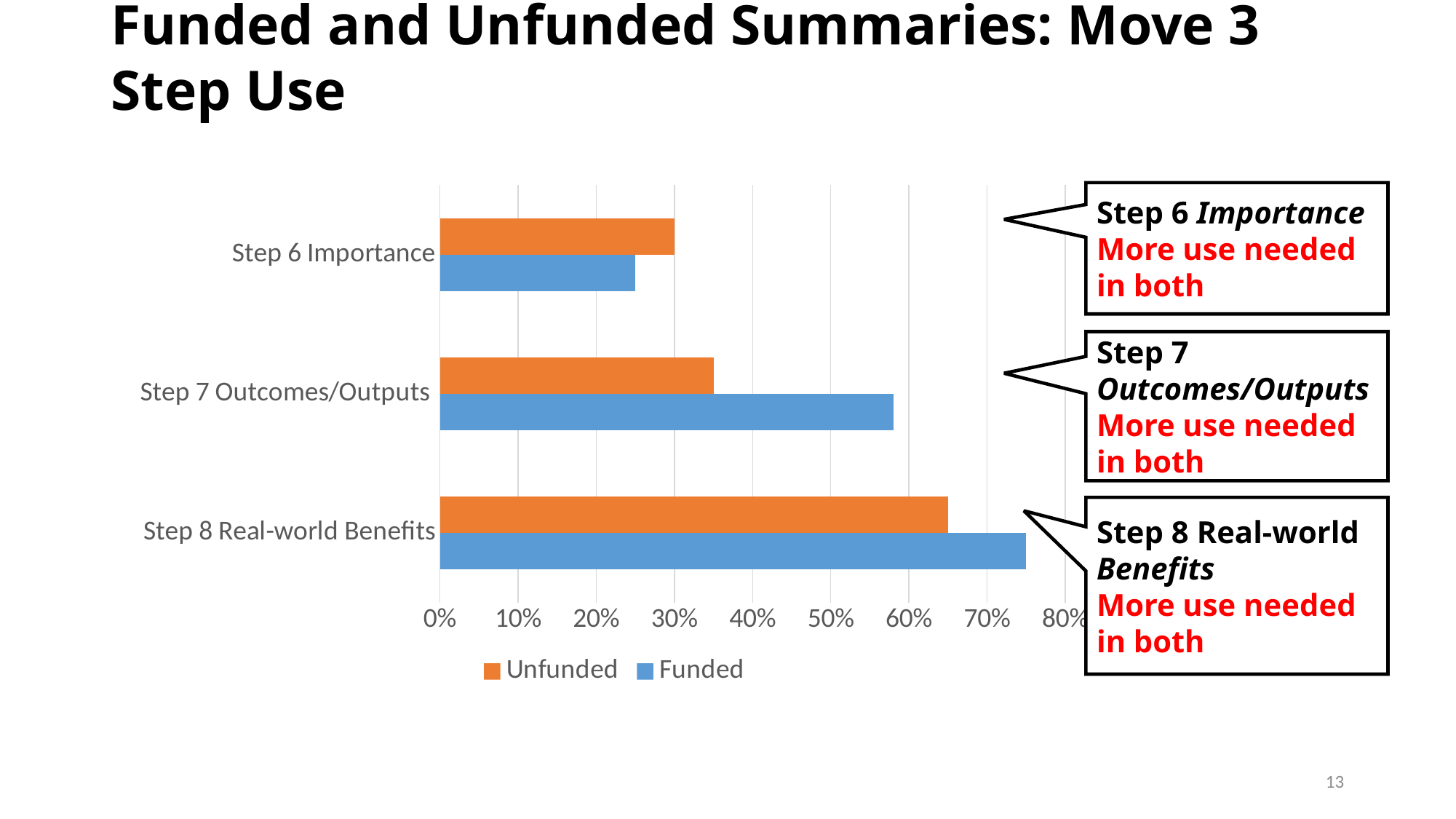
Which step has the highest Funded value? Step 8 Real-world Benefits For Step 7 Outcomes/Outputs, which is larger, the Funded or the Unfunded value? Funded For Step 6 Importance, which is larger, the Funded or the Unfunded value? Unfunded What colour represents the Unfunded series in the legend? orange Which step has the highest Unfunded value? Step 8 Real-world Benefits What kind of chart is shown on the slide? bar chart Is the Funded value for Step 8 Real-world Benefits greater or less than 70%? greater Is the Funded value for Step 7 Outcomes/Outputs greater or less than 50%? greater How many categories (steps) are plotted on the chart? 3 Which step has the lowest Funded value? Step 6 Importance How many series does the legend list? 2 Is the Funded value for Step 6 Importance greater or less than 30%? less